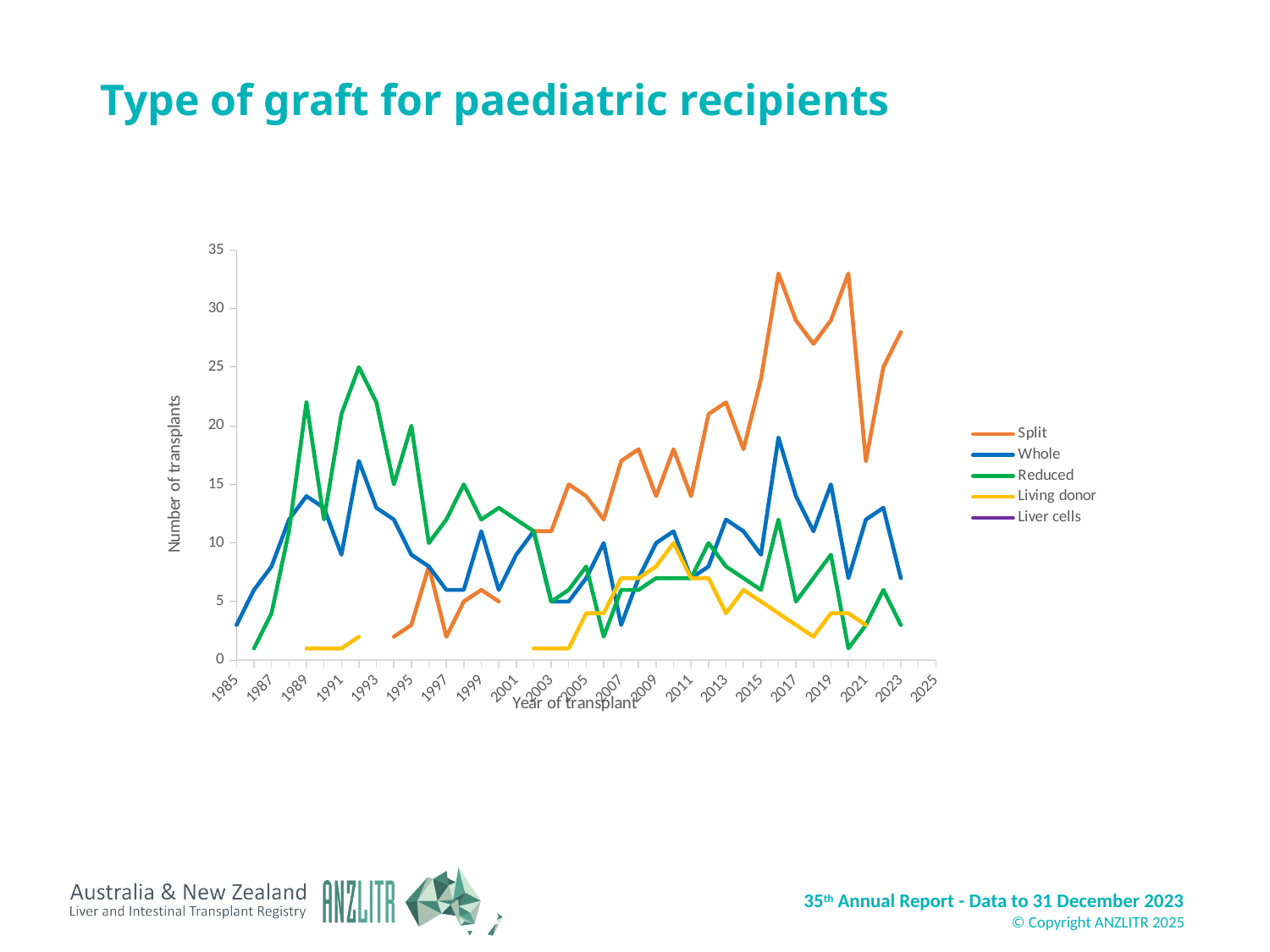
Is the value for Whole in 1985 greater or less than 5? less Which series reaches the highest value on the chart? Split What is the label on the vertical axis? Number of transplants Is the value for Split in 2016 greater or less than 30? greater In 1992, which is larger: Reduced or Whole? Reduced Is the value for Living donor in 2013 greater or less than 5? less What kind of chart is shown on the slide? Line chart Does the Reduced series generally rise or fall from 1992 to 2023? fall In 2016, which is larger: Split or Whole? Split How many series does the legend list? 5 What is the title of the chart? Type of graft for paediatric recipients